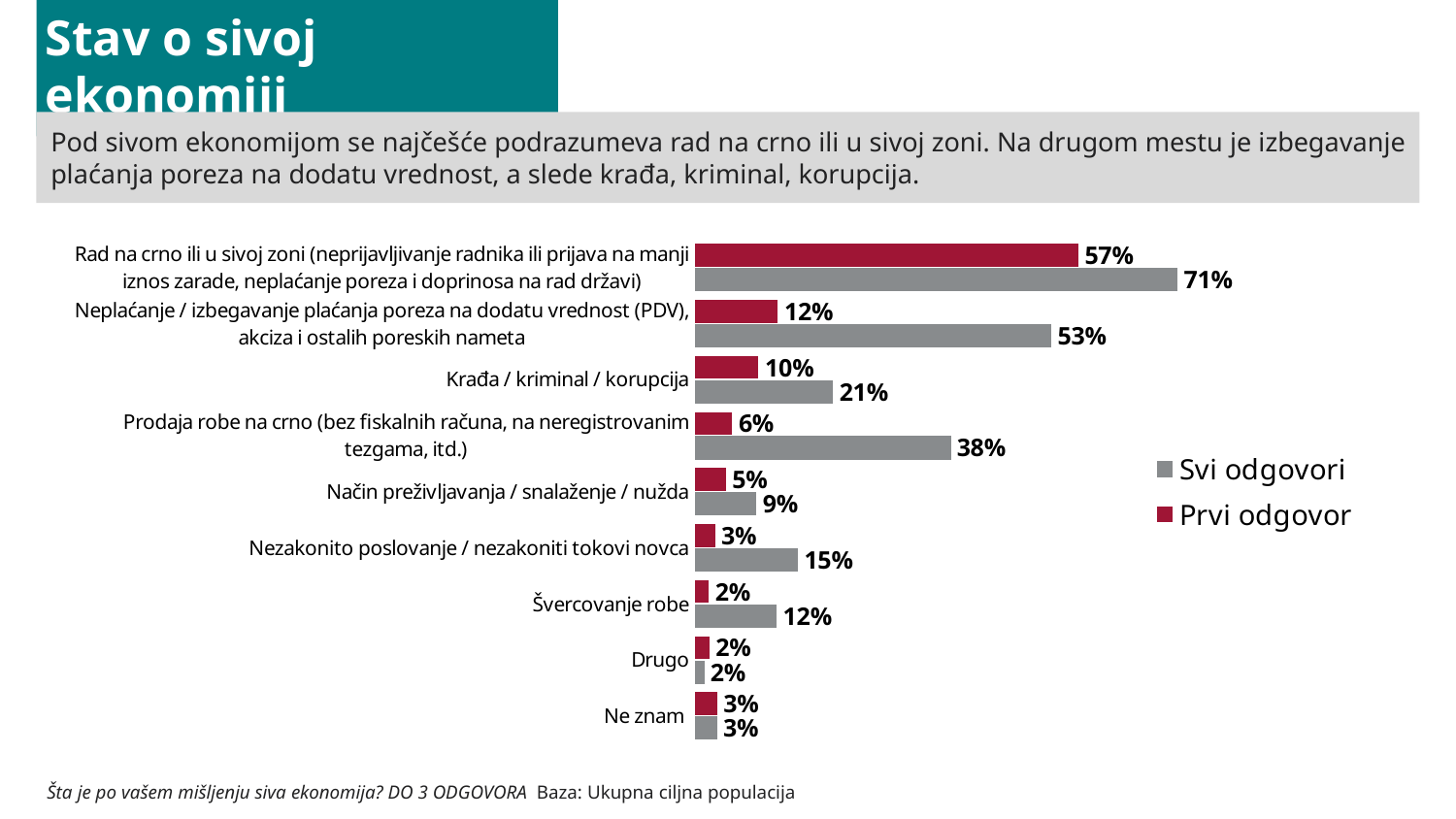
Which colour represents the "Prvi odgovor" series in the chart? Red What is the "Prvi odgovor" value for "Prodaja robe na crno (bez fiskalnih računa, na neregistrovanim tezgama, itd.)"? 6% What is the "Svi odgovori" value for "Krađa / kriminal / korupcija"? 21% What is the "Prvi odgovor" value for "Švercovanje robe"? 2% Which is larger: the "Svi odgovori" value for "Prodaja robe na crno" or the "Svi odgovori" value for "Krađa / kriminal / korupcija"? Prodaja robe na crno How many categories are shown in the chart? 9 What is the "Svi odgovori" value for "Nezakonito poslovanje / nezakoniti tokovi novca"? 15% What kind of chart is shown on the slide? Bar chart What is the difference between the "Svi odgovori" and "Prvi odgovor" values for "Neplaćanje / izbegavanje plaćanja poreza na dodatu vrednost (PDV), akciza i ostalih poreskih nameta"? 41 percentage points Which category has the lowest "Svi odgovori" value? Drugo How many series does the legend list? 2 Which category has the highest "Svi odgovori" value? Rad na crno ili u sivoj zoni (neprijavljivanje radnika ili prijava na manji iznos zarade, neplaćanje poreza i doprinosa na rad državi)